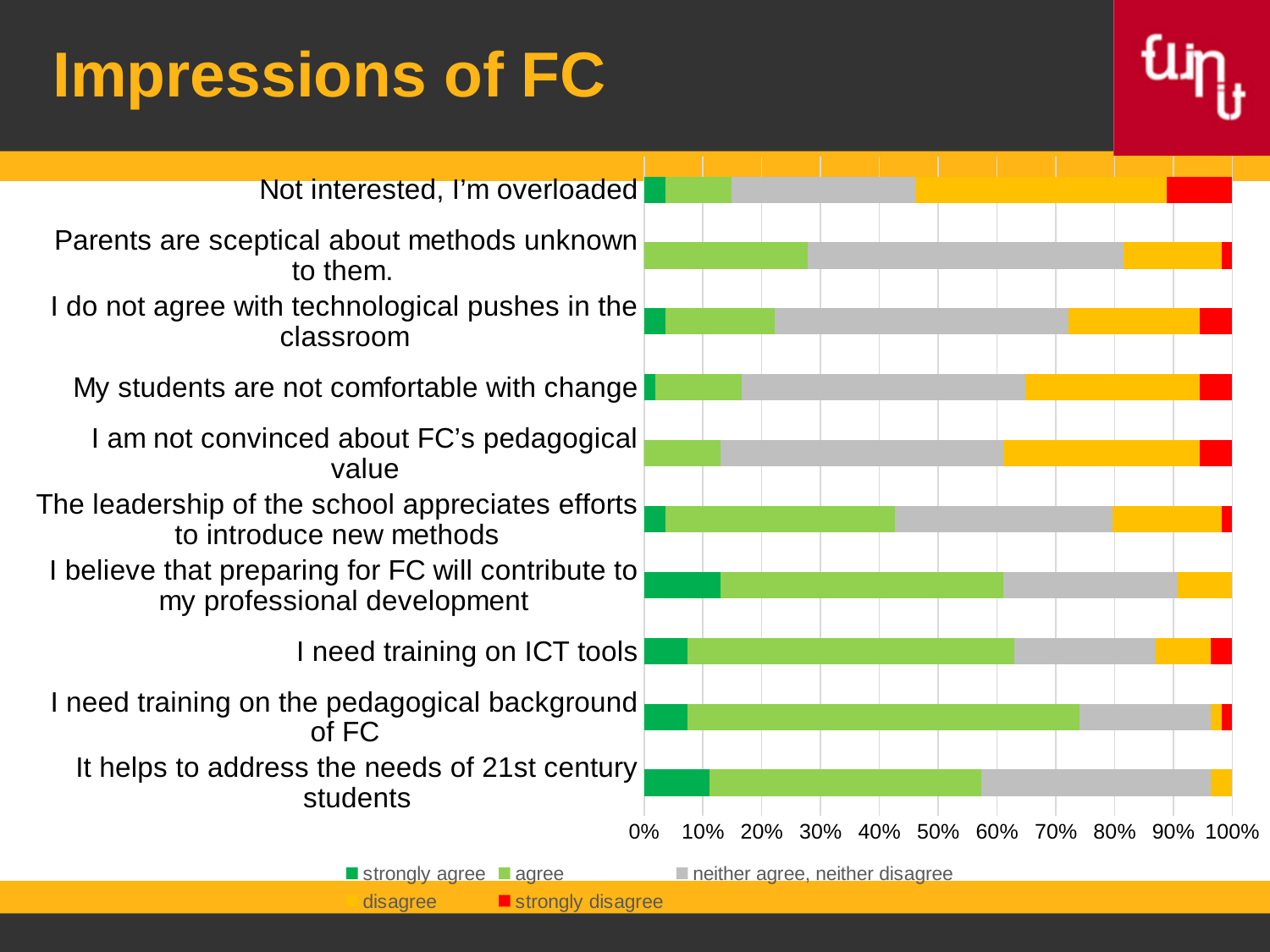
Which legend entry is shown in red? strongly disagree Is the 'agree' segment for 'I need training on the pedagogical background of FC' greater or less than 50%? greater Which statement has the largest 'agree' segment? I need training on the pedagogical background of FC What is the title of the slide containing the chart? Impressions of FC What do the segments of each stacked bar add up to, according to the x axis? 100% How many statements (categories) are plotted in the chart? 10 What kind of chart is shown on the slide? Stacked bar chart Which has a larger 'neither agree, neither disagree' segment: 'Parents are sceptical about methods unknown to them.' or 'Not interested, I'm overloaded'? Parents are sceptical about methods unknown to them. Which statement has the largest 'disagree' segment? Not interested, I'm overloaded Is the 'strongly agree' segment for 'I need training on ICT tools' greater or less than 20%? less How many series does the legend list? 5 Is the 'disagree' segment for 'Not interested, I'm overloaded' greater or less than 30%? greater